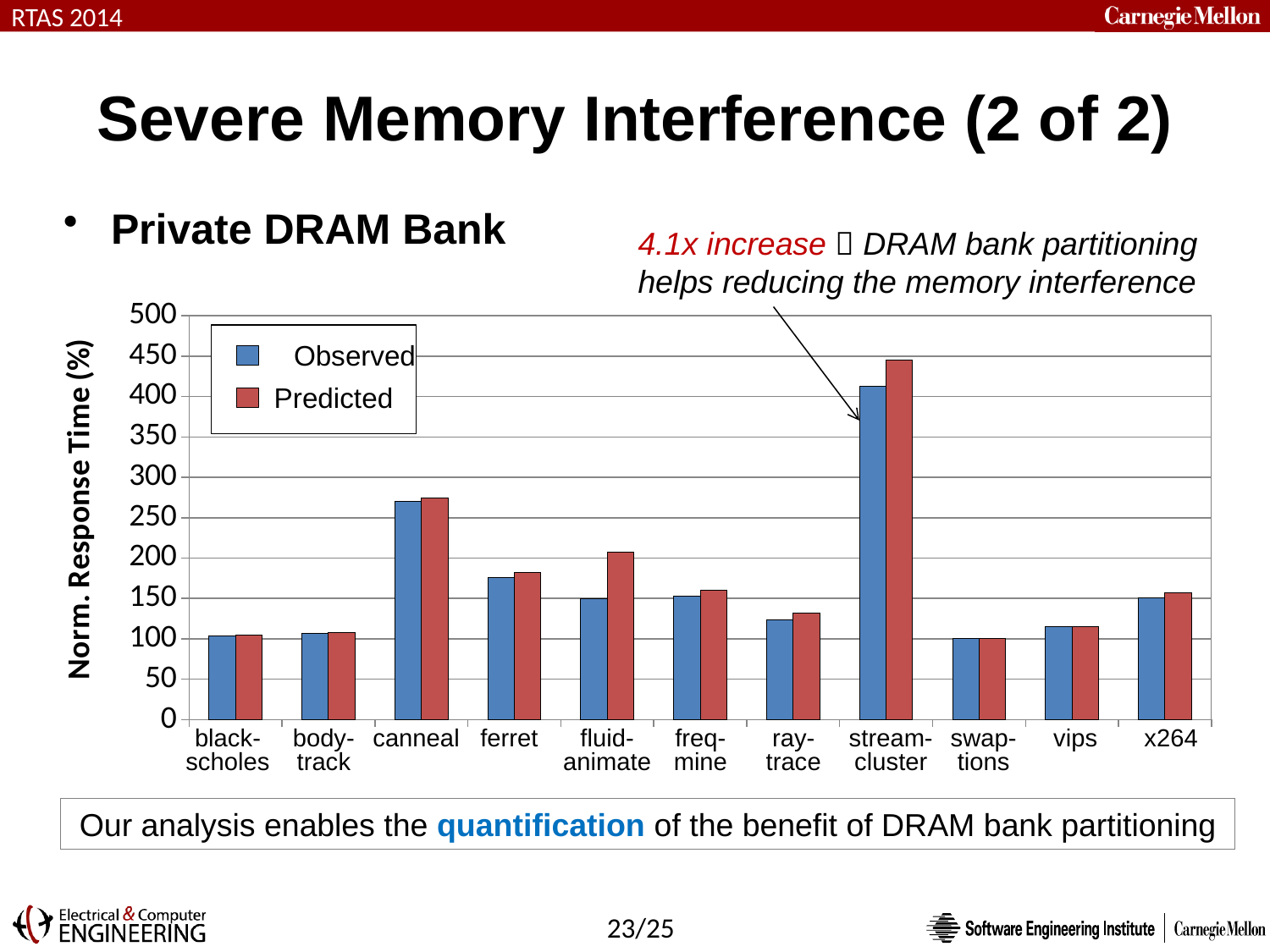
Which benchmark has the highest normalized response time? stream-cluster Which is larger for fluid-animate, the Observed or the Predicted value? Predicted Which benchmark has the larger Observed value, canneal or ferret? canneal Is the Observed value for canneal greater or less than 250? greater How many benchmark categories are shown on the x axis? 11 What is the label of the y axis? Norm. Response Time (%) Which colour represents the Predicted series in the legend? red What kind of chart is shown on the slide? bar chart Is the Observed value for vips greater or less than 150? less Is the Observed value for ferret greater or less than 200? less How many series does the legend list? 2